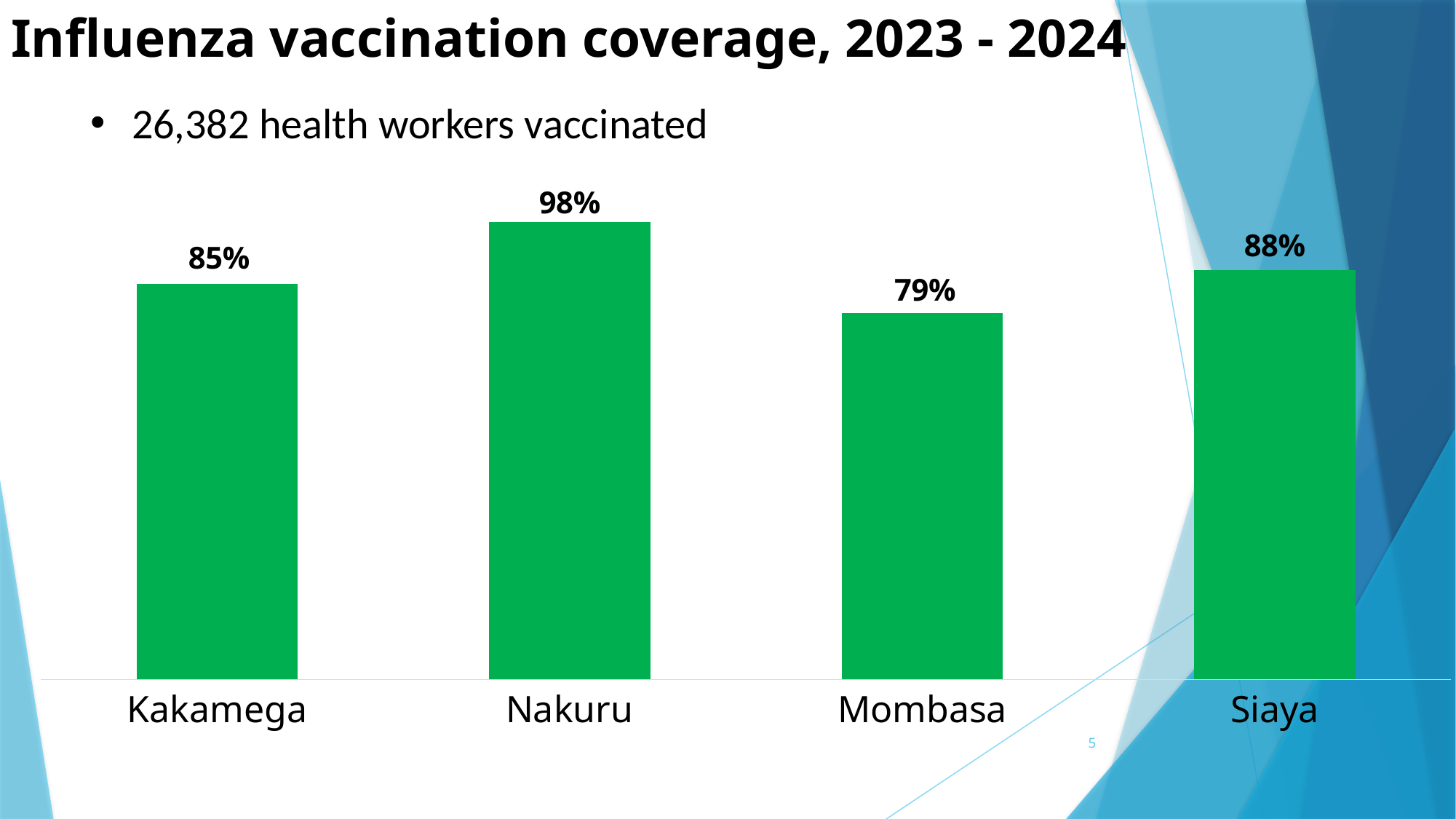
What is the influenza vaccination coverage for Nakuru? 98% How many counties are shown in the chart? 4 What kind of chart is shown on the slide? Bar chart What is the influenza vaccination coverage for Kakamega? 85% Which county has the lowest vaccination coverage? Mombasa What is the influenza vaccination coverage for Siaya? 88% What colour are the bars in the chart? Green Which has higher vaccination coverage, Kakamega or Siaya? Siaya What is the influenza vaccination coverage for Mombasa? 79% What is the difference in vaccination coverage between Siaya and Kakamega? 3% What is the difference in vaccination coverage between Nakuru and Mombasa? 19% Which county has the highest vaccination coverage? Nakuru